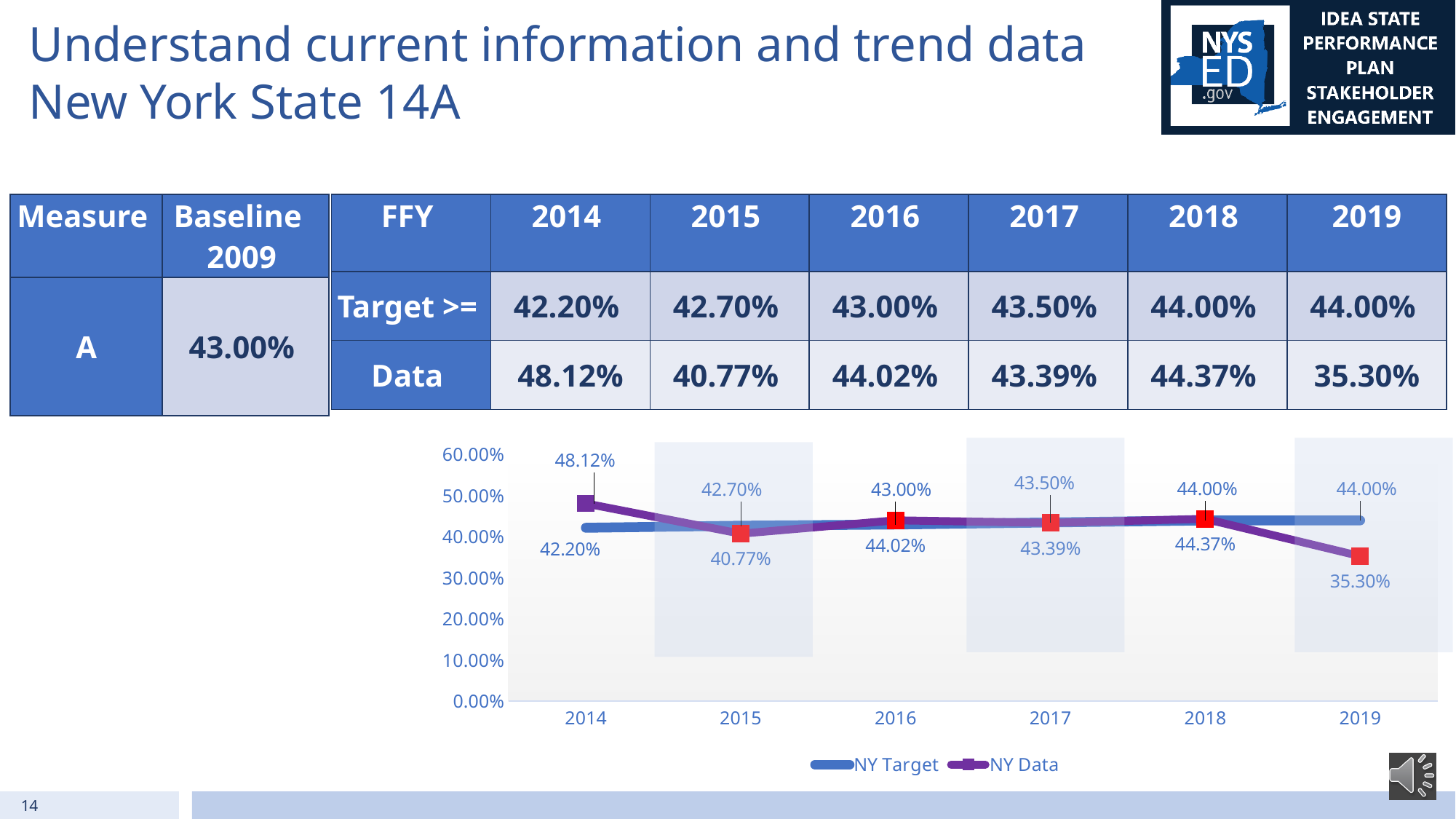
Which series is drawn in purple in the chart? NY Data What is the NY Target value for 2017? 43.50% How many years are plotted along the x axis of the chart? 6 What is the NY Data value for 2019? 35.30% Which is larger in 2015, the NY Target value or the NY Data value? NY Target What is the difference between the NY Target and NY Data values in 2019? 8.70% What type of chart is shown on the slide? line chart In which year is the NY Data value lowest? 2019 What is the NY Data value for 2014? 48.12% How many series does the chart legend list? 2 In which year is the NY Data value highest? 2014 Does the NY Target series rise or fall from 2014 to 2018? rise